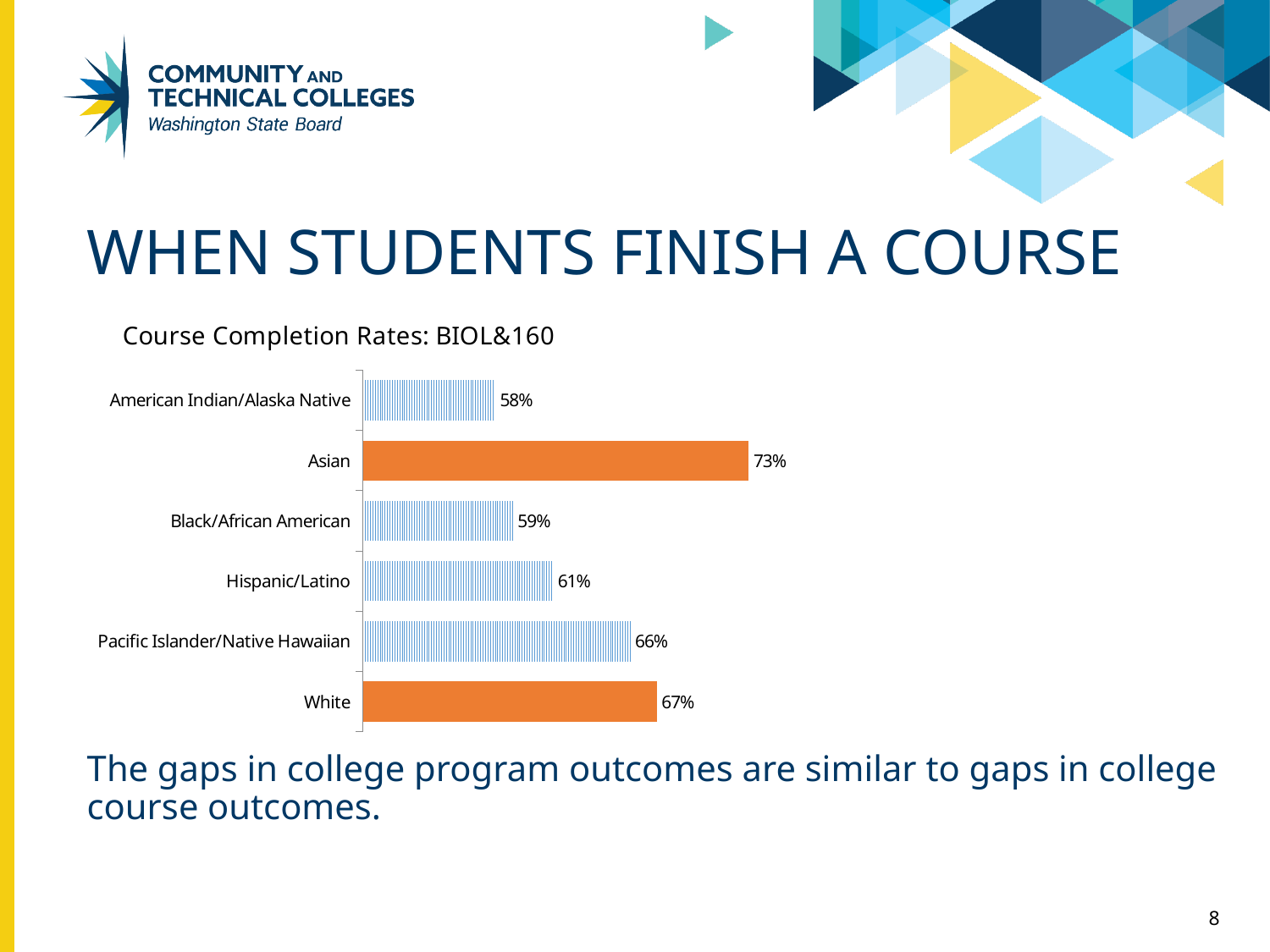
What is the course completion rate for Asian students? 73% Which has a higher completion rate, White or Pacific Islander/Native Hawaiian? White What is the difference between the completion rates for Asian and Black/African American students? 14% What is the course completion rate for Hispanic/Latino students? 61% What is the course completion rate for Pacific Islander/Native Hawaiian students? 66% Which group has the highest course completion rate? Asian What is the course completion rate for American Indian/Alaska Native students? 58% Which group has the lowest course completion rate? American Indian/Alaska Native How many groups are shown in the chart? 6 What is the difference between the completion rates for White and American Indian/Alaska Native students? 9% What is the title of the chart? Course Completion Rates: BIOL&160 What type of chart is shown on the slide? Bar chart